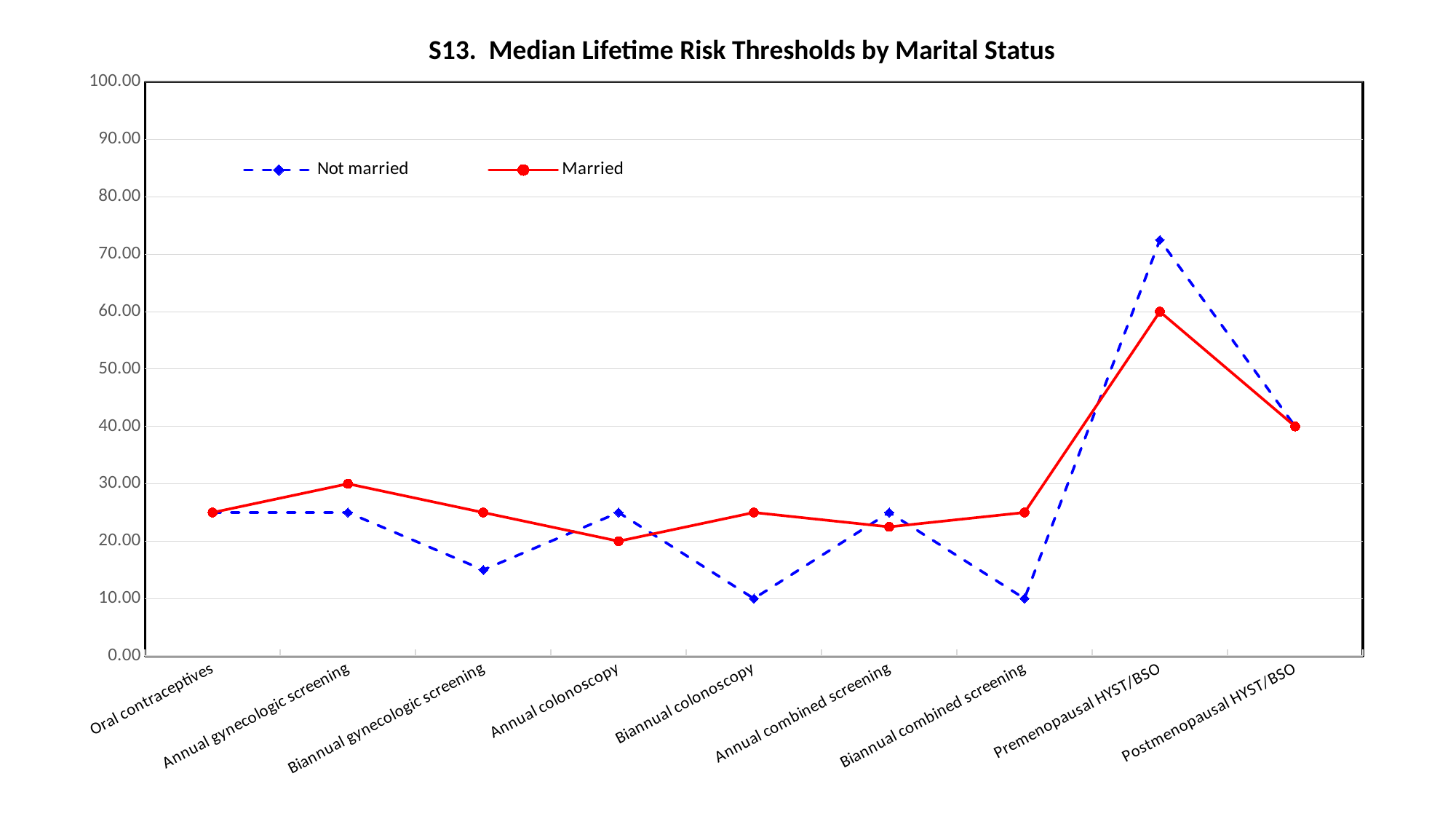
What is the Married value for Annual gynecologic screening? 30.00 What is the difference between the Married values for Premenopausal HYST/BSO and Postmenopausal HYST/BSO? 20.00 For which category is the Married value highest? Premenopausal HYST/BSO For Biannual gynecologic screening, which series has the larger value, Not married or Married? Married For which category is the Not married value highest? Premenopausal HYST/BSO How many categories are shown on the x axis? 9 What kind of chart is shown on the slide? line chart Is the Not married value for Premenopausal HYST/BSO greater or less than 70.00? greater How many series does the legend list? 2 What is the Married value for Premenopausal HYST/BSO? 60.00 What is the title of the chart? S13. Median Lifetime Risk Thresholds by Marital Status What is the Not married value for Biannual colonoscopy? 10.00